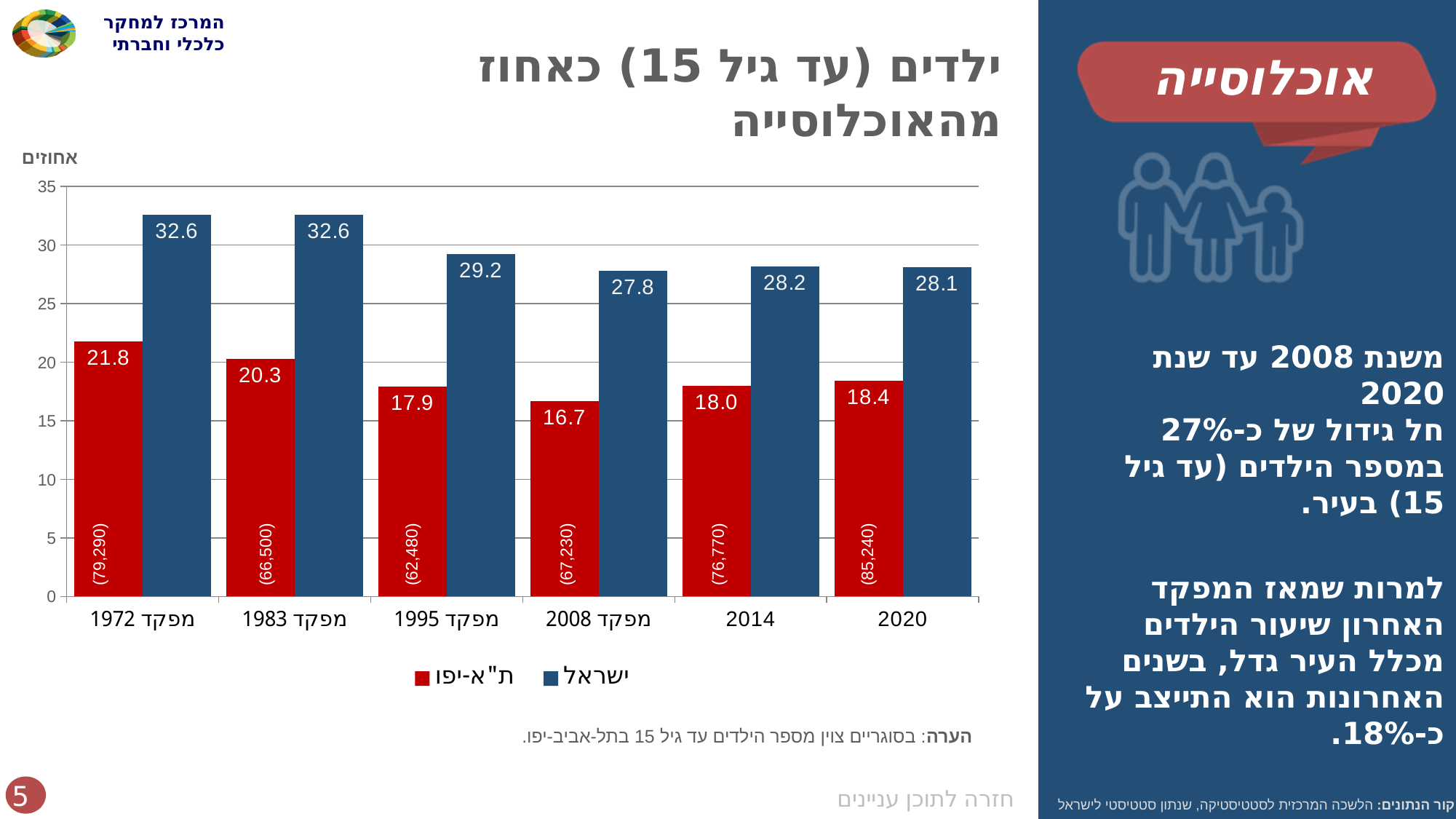
What number of children in Tel Aviv-Yafo is shown in parentheses for 2020? (85,240) In which year is the ת"א-יפו (Tel Aviv-Yafo) value highest? מפקד 1972 Which is larger in 2014: the value for ישראל or for ת"א-יפו? ישראל How many series does the legend list? 2 What is the value for ת"א-יפו (Tel Aviv-Yafo) in מפקד 2008? 16.7 What is the value for ישראל (Israel) in מפקד 1972? 32.6 What kind of chart is shown on the slide? bar chart Which colour represents ת"א-יפו (Tel Aviv-Yafo) in the chart? red How many year categories are shown on the x axis? 6 In which year is the ת"א-יפו (Tel Aviv-Yafo) value lowest? מפקד 2008 What is the value for ת"א-יפו (Tel Aviv-Yafo) in 2020? 18.4 What is the difference between the ישראל and ת"א-יפו values in מפקד 1995? 11.3